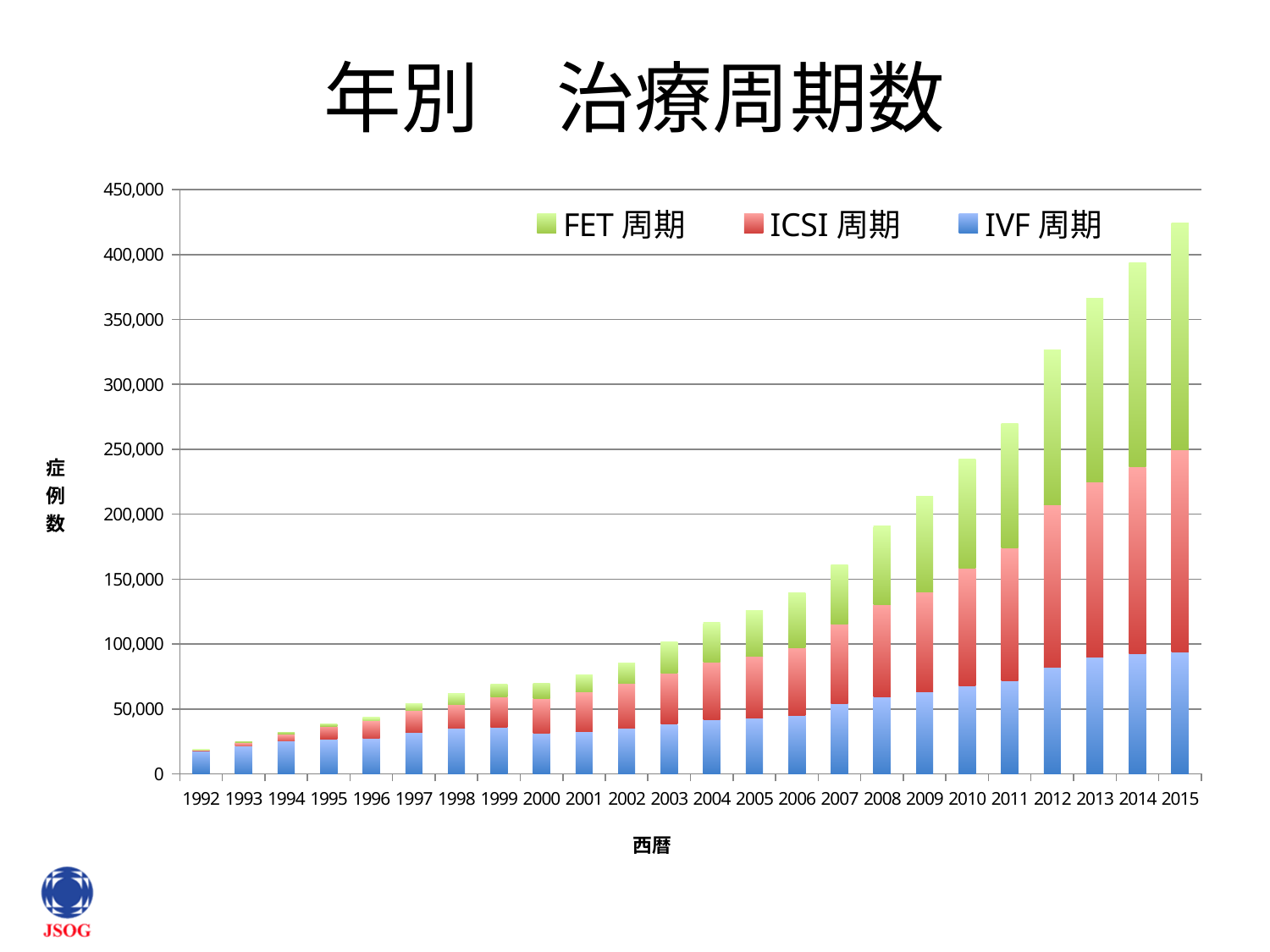
Is the total value for 2014 greater or less than 400,000? less Which year has a larger total, 2003 or 2002? 2003 Which year has the highest total number of treatment cycles? 2015 What kind of chart is shown on the slide? Stacked bar chart How many series does the legend list? 3 Is the total value for 2015 greater or less than 400,000? greater Do the total treatment cycle counts rise or fall from 1992 to 2015? rise Which year has the lowest total number of treatment cycles? 1992 How many years are shown on the x axis? 24 Is the total value for 2010 greater or less than 250,000? less What are the three series named in the legend? FET 周期, ICSI 周期, IVF 周期